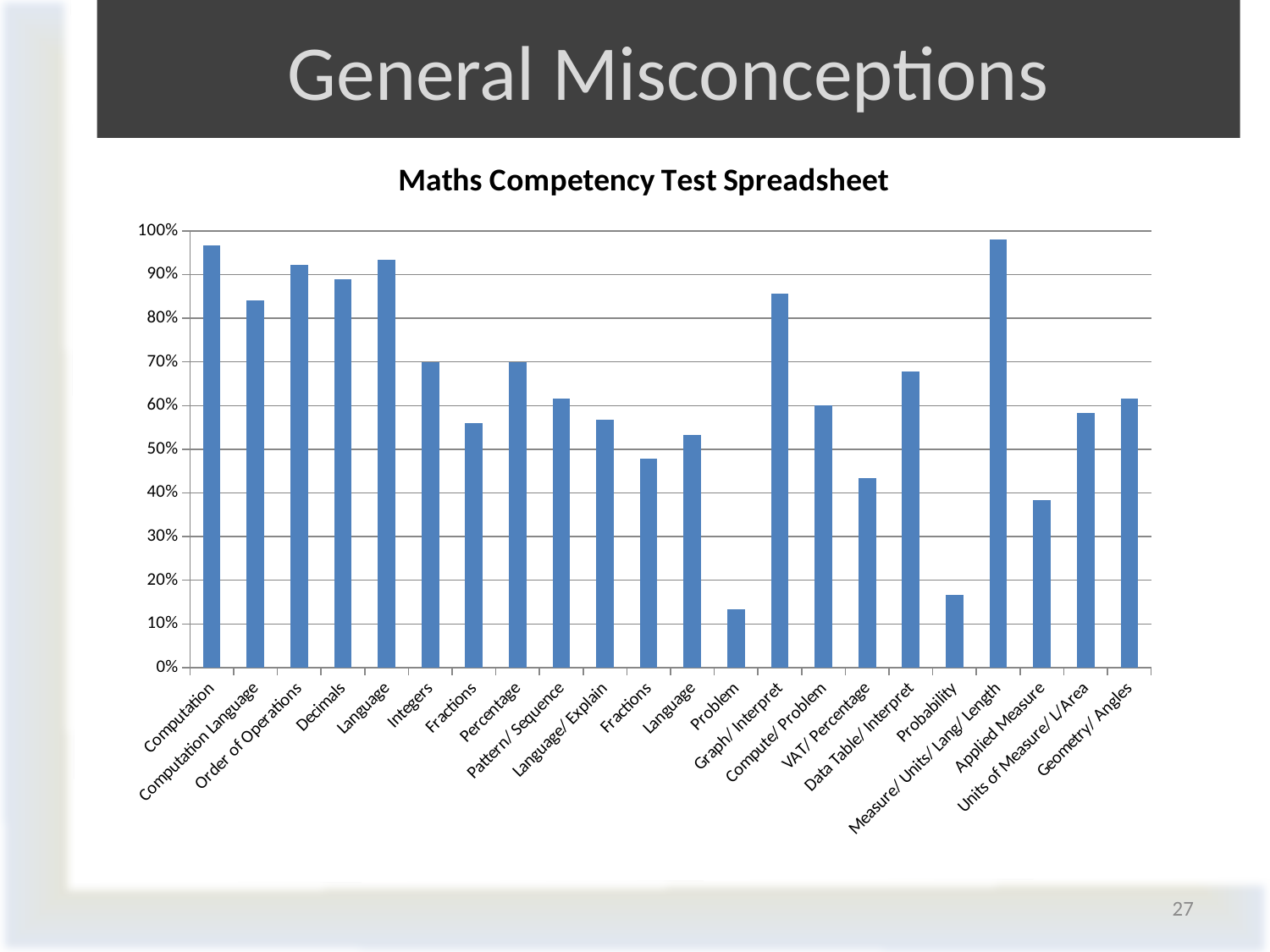
How many categories are plotted along the x axis? 22 Which category has the lowest value? Problem Which is larger, the value for Graph/ Interpret or the value for Compute/ Problem? Graph/ Interpret Is the value for Decimals greater or less than 80%? greater Is the value for Measure/ Units/ Lang/ Length greater or less than 90%? greater Which is larger, the value for Data Table/ Interpret or the value for Probability? Data Table/ Interpret What kind of chart is shown on the slide? bar chart Is the value for Graph/ Interpret greater or less than 80%? greater What is the title of the chart? Maths Competency Test Spreadsheet